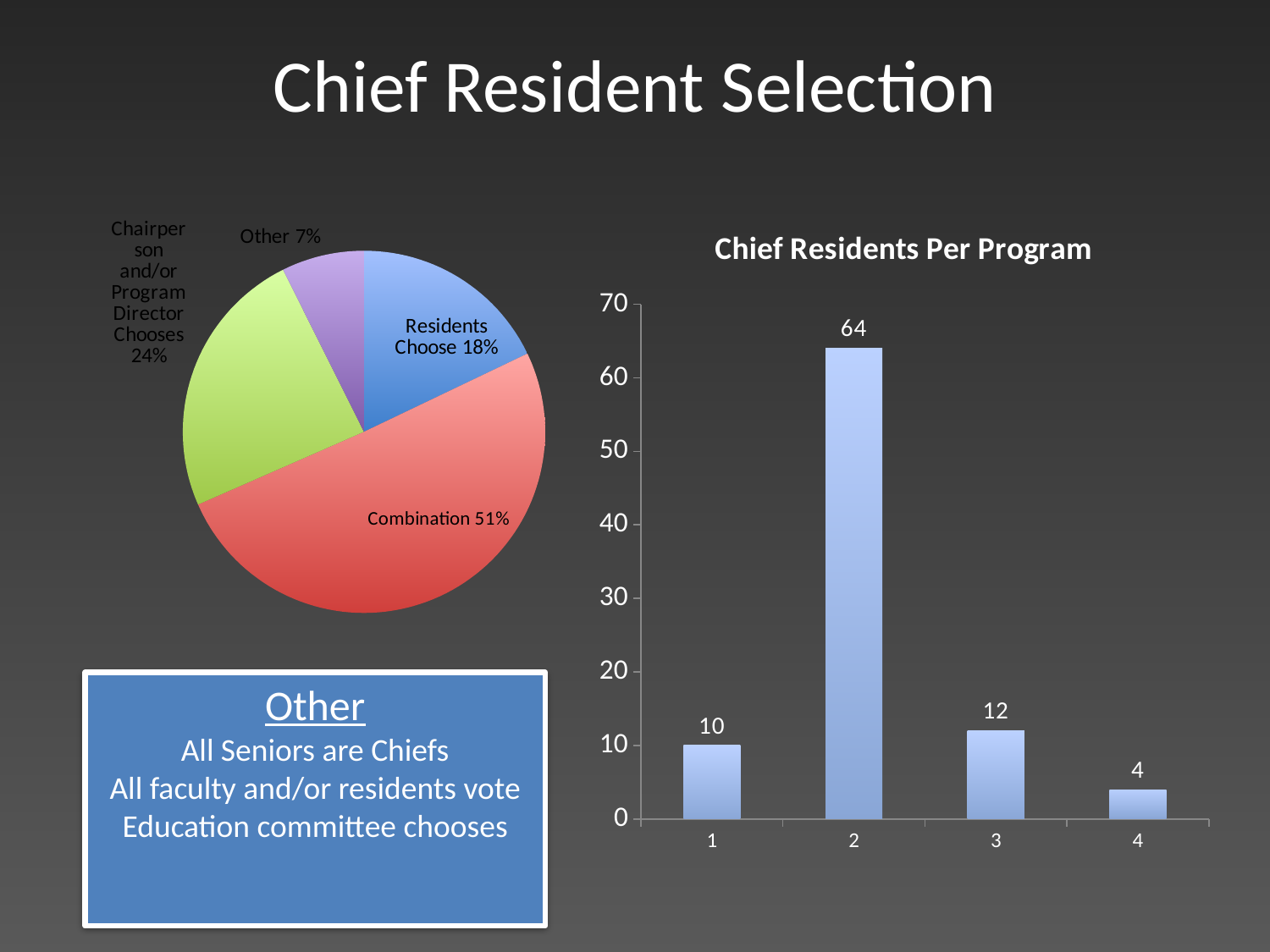
In the 'Chief Residents Per Program' bar chart, what is the difference between the values for category 2 and category 3? 52 What kind of chart is the 'Chief Residents Per Program' chart? bar chart How many categories are shown in the 'Chief Residents Per Program' bar chart? 4 In the 'Chief Residents Per Program' bar chart, which is larger, the value for category 1 or category 3? 3 In the pie chart on the left, what share does 'Combination' have? 51% In the pie chart on the left, which slice is the smallest? Other In the 'Chief Residents Per Program' bar chart, which category has the highest value? 2 How many slices does the pie chart on the left have? 4 In the 'Chief Residents Per Program' bar chart, what is the value for category 4? 4 In the pie chart on the left, what share does 'Residents Choose' have? 18% In the 'Chief Residents Per Program' bar chart, which category has the lowest value? 4 In the 'Chief Residents Per Program' bar chart, what is the value for category 2? 64